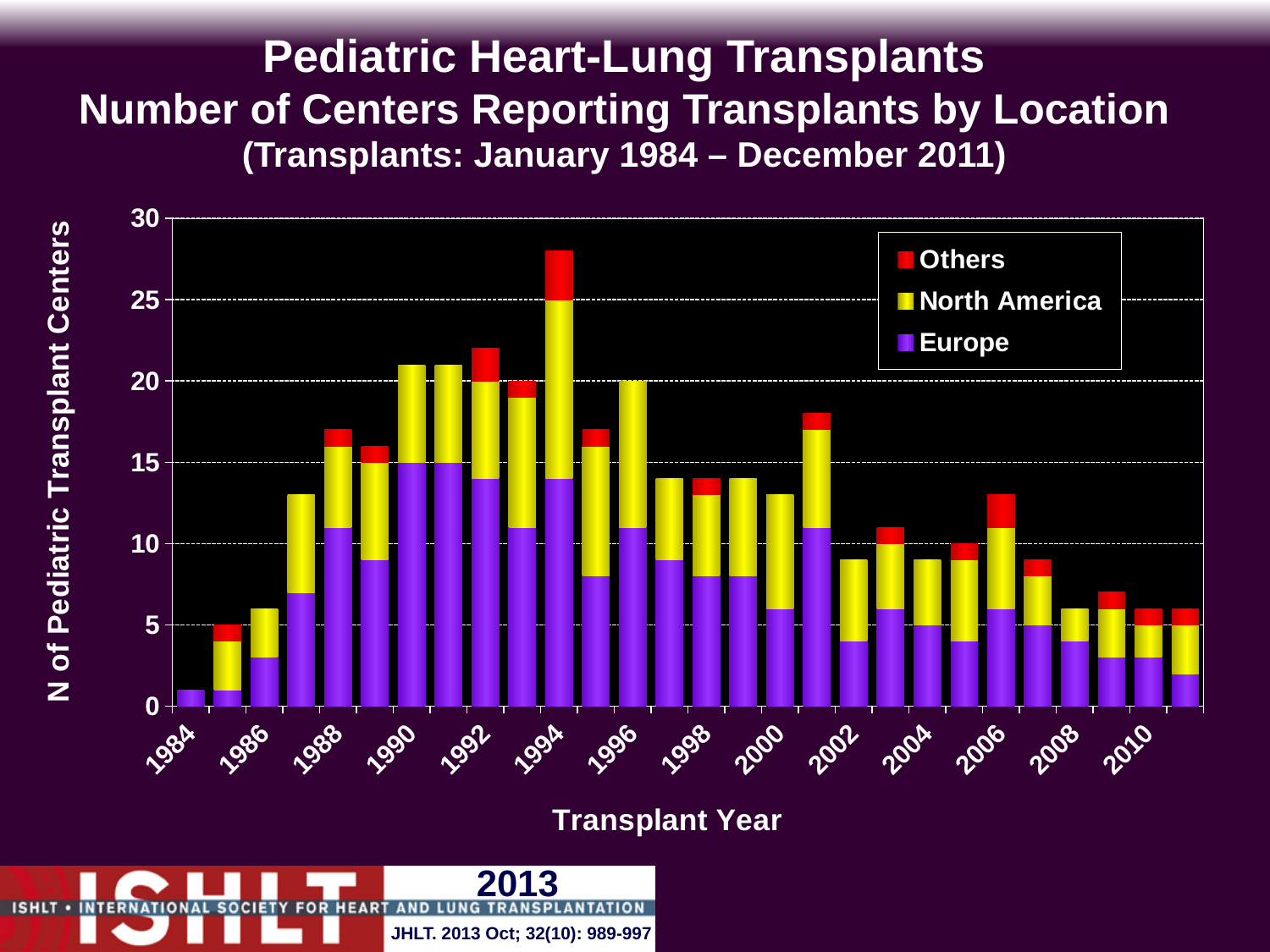
Is the number of Europe centers in 1990 greater or less than 10? greater What kind of chart is shown on the slide? Stacked bar chart Which transplant year has the highest total number of pediatric transplant centers? 1994 How does the total number of centers change from 1994 to 2011? It falls Is the total number of centers for 2008 greater or less than 10? less How many series does the legend list? 3 Which year has a larger total number of centers, 1994 or 1990? 1994 Which year has a larger total number of centers, 2001 or 2002? 2001 Is the total number of centers for 1994 greater or less than 25? greater What is the label of the x axis? Transplant Year Which series is shown in red in the legend? Others Which transplant year has the lowest total number of pediatric transplant centers? 1984